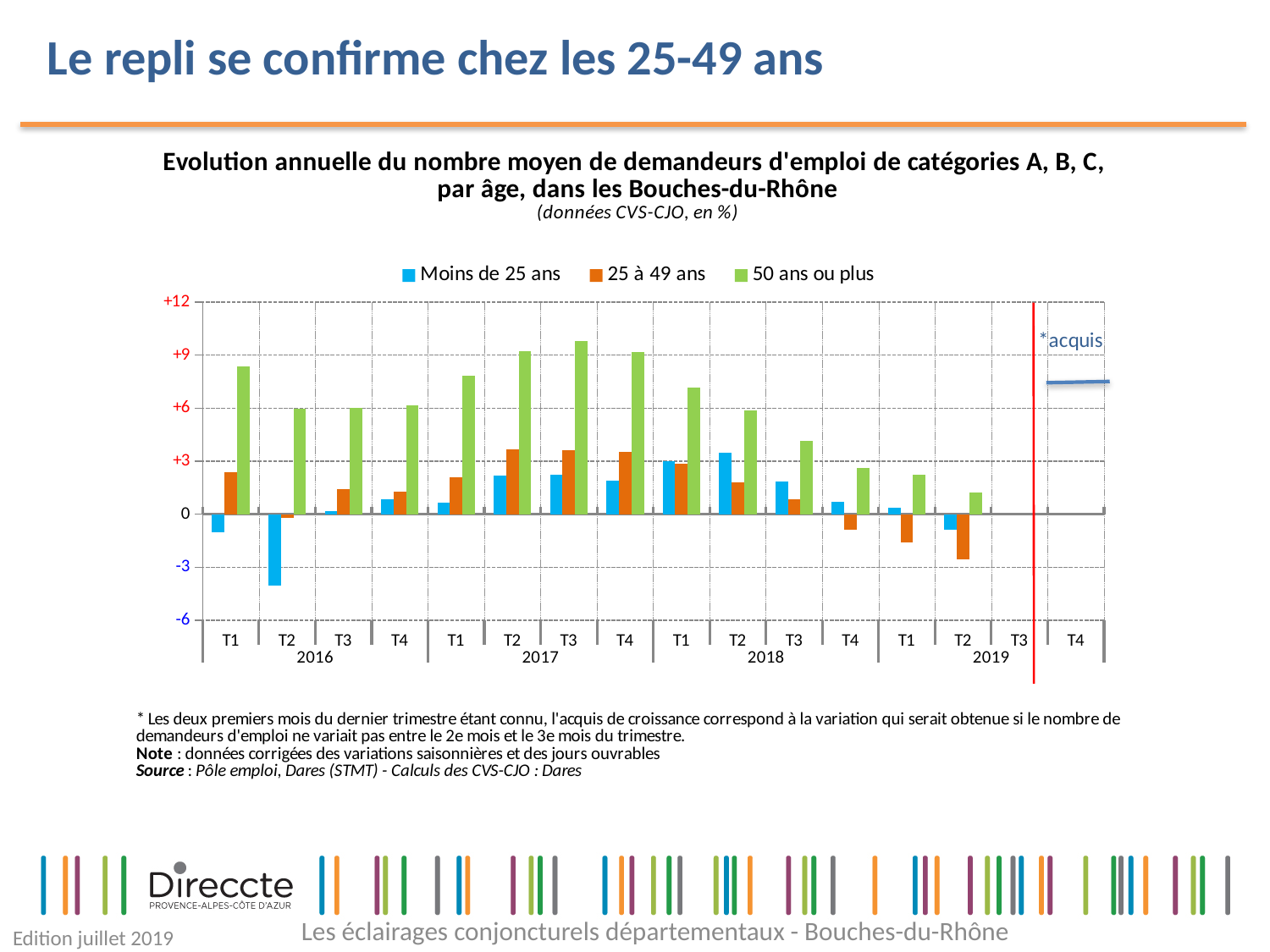
From T3 2017 to T2 2019, do the values for '50 ans ou plus' rise or fall? fall How many quarter labels (T1–T4) appear along the x axis? 16 In which quarter does the '50 ans ou plus' series reach its highest value? T3 2017 What kind of chart is shown on the slide? Bar chart How many series does the legend list? 3 In which quarter does the 'Moins de 25 ans' series reach its lowest value? T2 2016 Is the value for '25 à 49 ans' in T2 2019 greater or less than 0? less Is the value for 'Moins de 25 ans' in T2 2016 greater or less than -3? less Is the value for '50 ans ou plus' in T3 2017 greater or less than +9? greater Which series is shown in green in the legend? 50 ans ou plus In T3 2017, which is larger: the value for '50 ans ou plus' or for '25 à 49 ans'? 50 ans ou plus